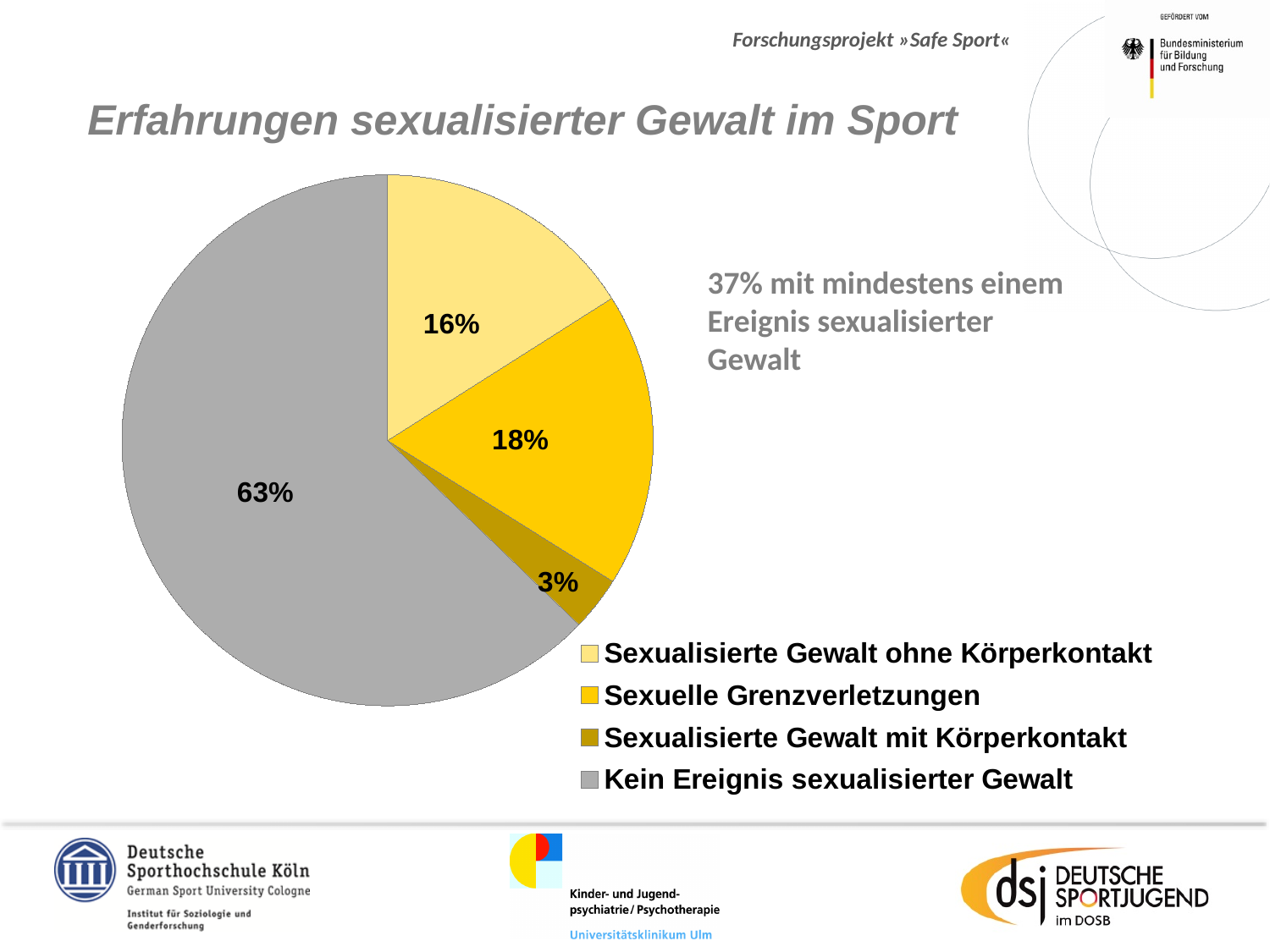
How many slices does the pie chart have? 4 What kind of chart is shown on the slide? Pie chart Which is larger: the slice for "Sexuelle Grenzverletzungen" or the slice for "Sexualisierte Gewalt mit Körperkontakt"? Sexuelle Grenzverletzungen Which category has the largest slice of the pie? Kein Ereignis sexualisierter Gewalt What share of the pie is labelled "Kein Ereignis sexualisierter Gewalt"? 63% What share of the pie is labelled "Sexualisierte Gewalt mit Körperkontakt"? 3% What share of the pie is labelled "Sexuelle Grenzverletzungen"? 18% What is the difference in percentage points between "Sexuelle Grenzverletzungen" and "Sexualisierte Gewalt ohne Körperkontakt"? 2 percentage points What colour is the slice for "Kein Ereignis sexualisierter Gewalt"? Grey What is the combined share of the three slices representing experiences of sexualised violence (16%, 18% and 3%)? 37% What share of the pie is labelled "Sexualisierte Gewalt ohne Körperkontakt"? 16% Which category has the smallest slice of the pie? Sexualisierte Gewalt mit Körperkontakt